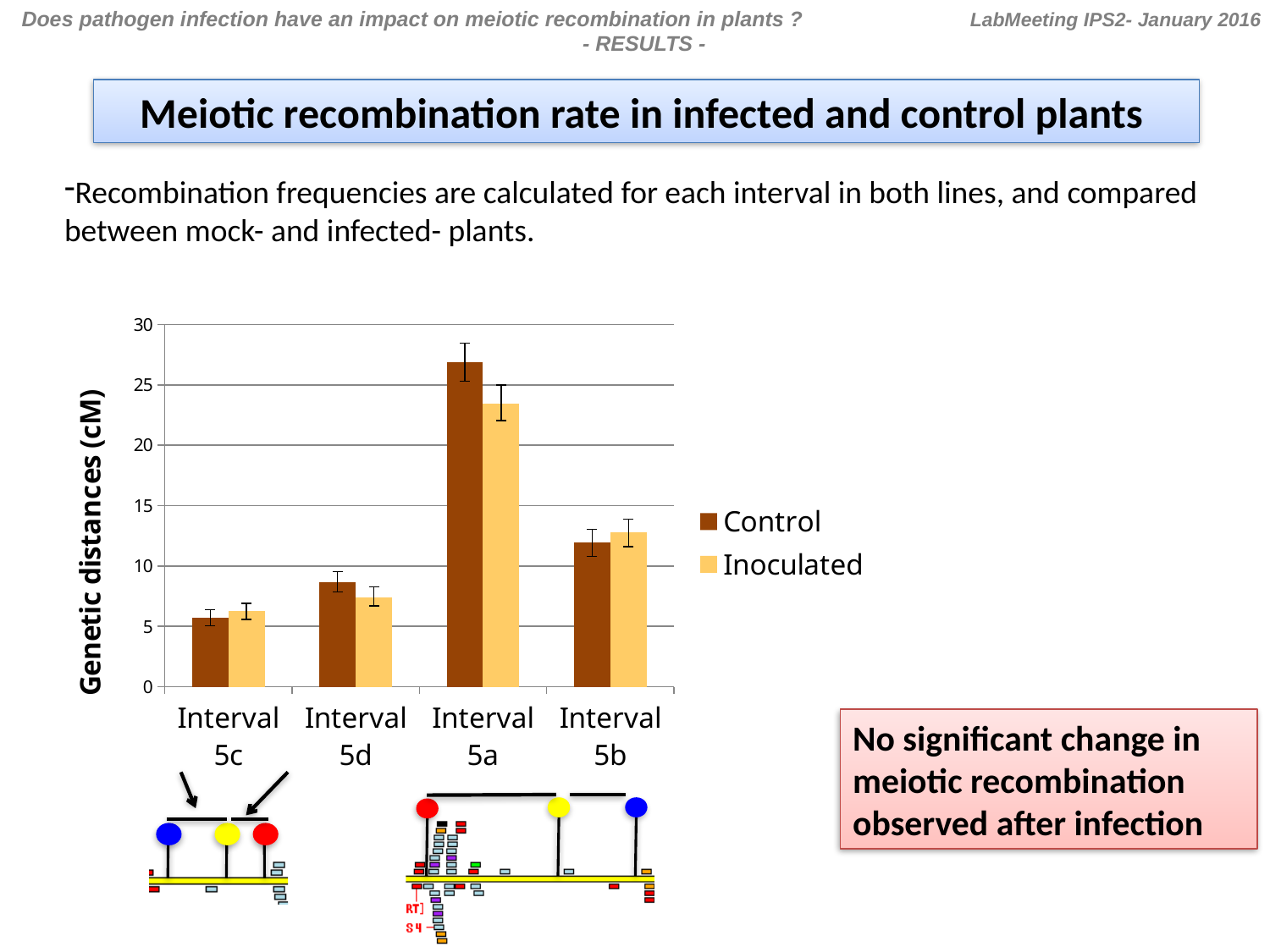
Is the Control value for Interval 5a greater or less than 25? greater Which interval has the highest Control value in the chart? Interval 5a Is the Control value for Interval 5d greater or less than 10? less What is the title of the chart's y axis? Genetic distances (cM) Which interval has the lowest Inoculated value in the chart? Interval 5c Is the Inoculated value for Interval 5a greater or less than 25? less For Interval 5d, which is larger: the Control value or the Inoculated value? Control What kind of chart is shown on the slide? bar chart How many series does the chart's legend list? 2 How many intervals (categories) are plotted on the x axis of the chart? 4 For Interval 5a, which is larger: the Control value or the Inoculated value? Control